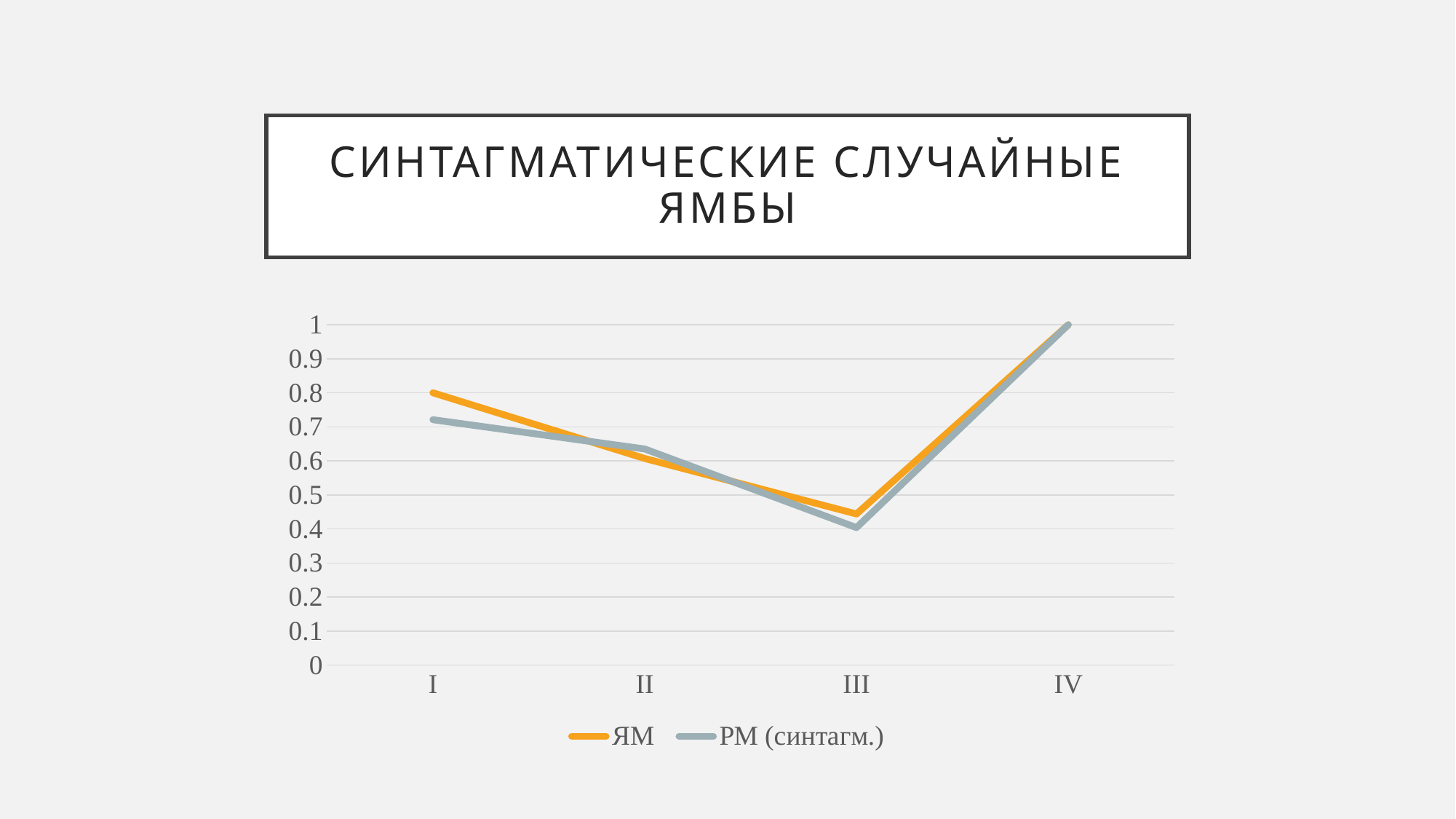
At which category is the ЯМ series lowest? III What kind of chart is shown on the slide? line chart At category I, which series has the larger value, ЯМ or РМ (синтагм.)? ЯМ How many categories are shown on the x axis? 4 What is the value of ЯМ at category IV? 1 Does the ЯМ series rise or fall from category I to category III? fall What is the value of РМ (синтагм.) at category IV? 1 How many series does the legend list? 2 Is the value for РМ (синтагм.) at category II greater or less than 0.6? greater Is the value for ЯМ at category III greater or less than 0.5? less At which category is the РМ (синтагм.) series highest? IV What is the value of ЯМ at category I? 0.8